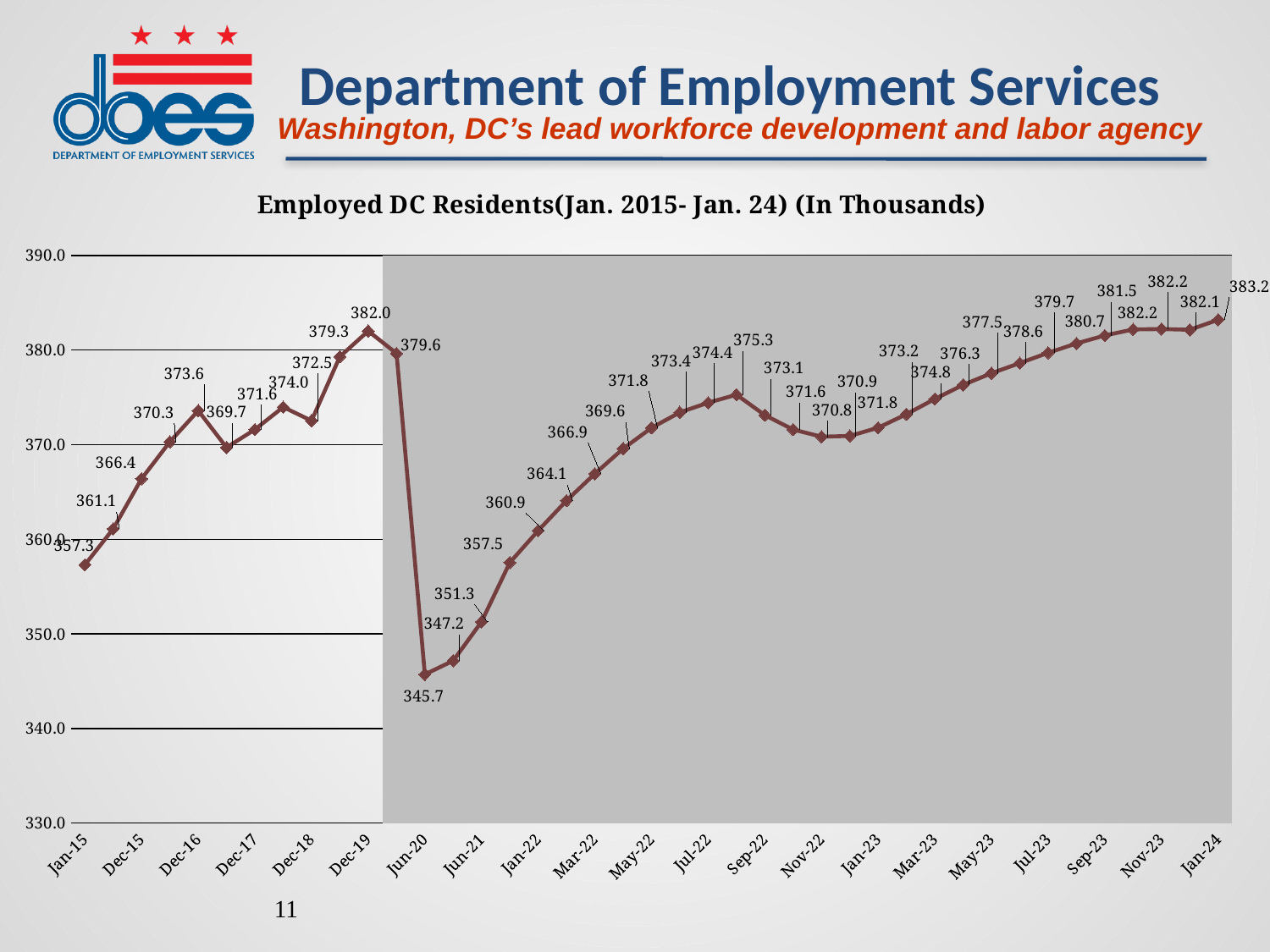
What is the value for Dec-19? 382.0 Which point on the chart has the lowest value? Jun-20 What is the difference between the value for Jan-24 and the value for Jan-15? 25.9 What is the value for Jan-15? 357.3 What is the value for Jan-24? 383.2 Which point on the chart has the highest value? Jan-24 Which is larger, the value for Dec-19 or the value for Jan-24? Jan-24 Is the value for Jun-20 greater or less than 350.0? less What type of chart is shown on the slide? Line chart What is the value for Jun-20? 345.7 What is the difference between the value for Jan-24 and the value for Jun-20? 37.5 What is the title of the chart? Employed DC Residents(Jan. 2015- Jan. 24) (In Thousands)